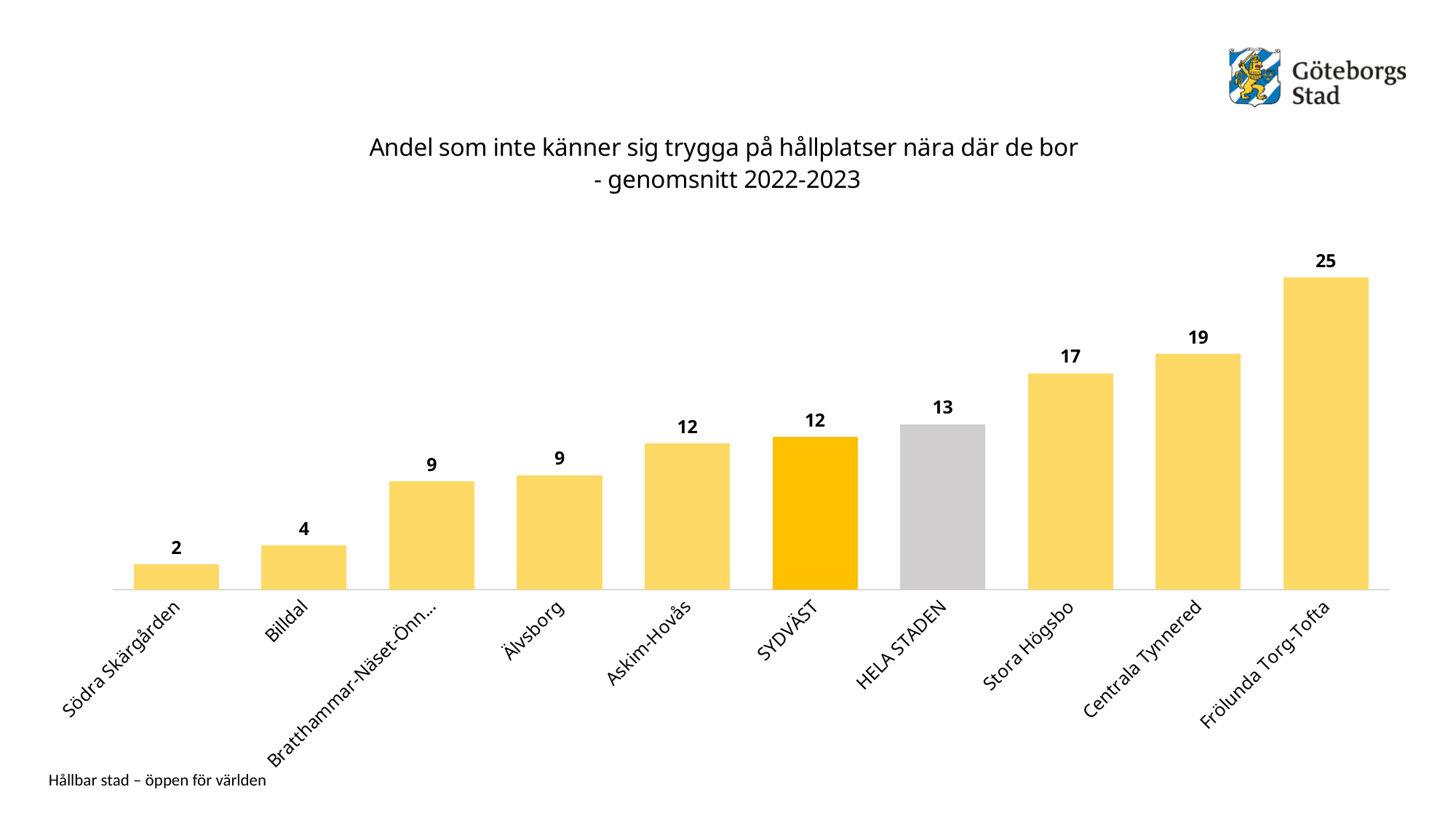
What is the value for Frölunda Torg-Tofta? 25 What is the value for Billdal? 4 What is the value for SYDVÄST? 12 How many categories are shown on the x axis? 10 What is the difference between the values for HELA STADEN and SYDVÄST? 1 Which category has the lowest value? Södra Skärgården Which category has the highest value? Frölunda Torg-Tofta What is the difference between the values for Frölunda Torg-Tofta and Centrala Tynnered? 6 Which is larger, the value for Stora Högsbo or the value for Askim-Hovås? Stora Högsbo What kind of chart is shown on the slide? Bar chart What is the value for HELA STADEN? 13 Do the values rise or fall from left to right along the x axis? Rise